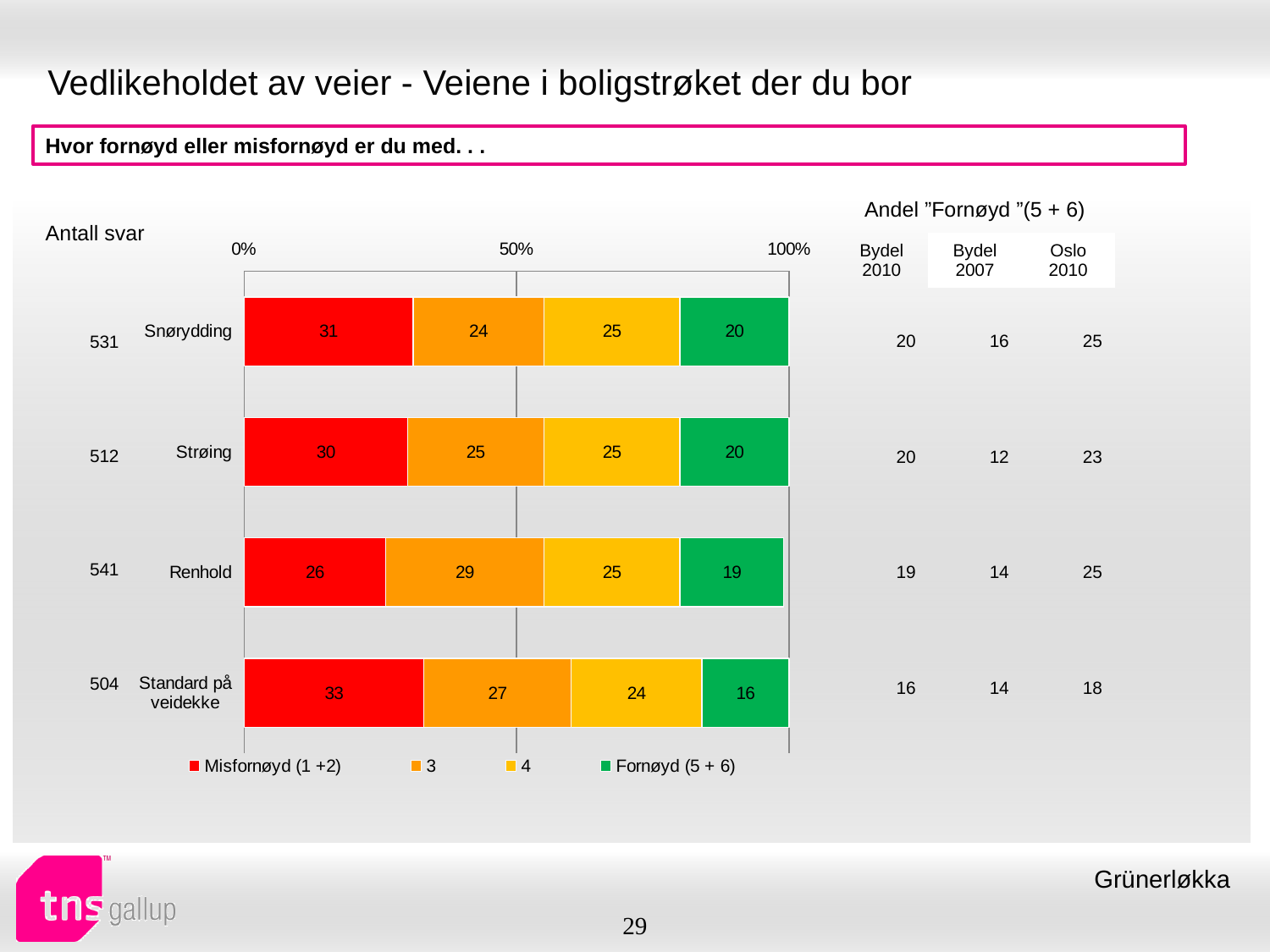
How many series does the legend list? 4 Which is larger: the '3' segment for Strøing or the '3' segment for Snørydding? Strøing What is the value of the Fornøyd (5 + 6) segment for Standard på veidekke? 16 How many categories does the bar chart show? 4 What is the difference between the Misfornøyd (1 +2) values for Standard på veidekke and Renhold? 7 What kind of chart is shown on the slide? stacked bar chart What is the total of the stacked bar for Strøing? 100 What is the value of the Misfornøyd (1 +2) segment for Snørydding? 31 What is the value of the '3' segment for Renhold? 29 Which category has the lowest Fornøyd (5 + 6) value? Standard på veidekke Which colour represents the Fornøyd (5 + 6) series in the legend? green Which category has the highest Misfornøyd (1 +2) value? Standard på veidekke